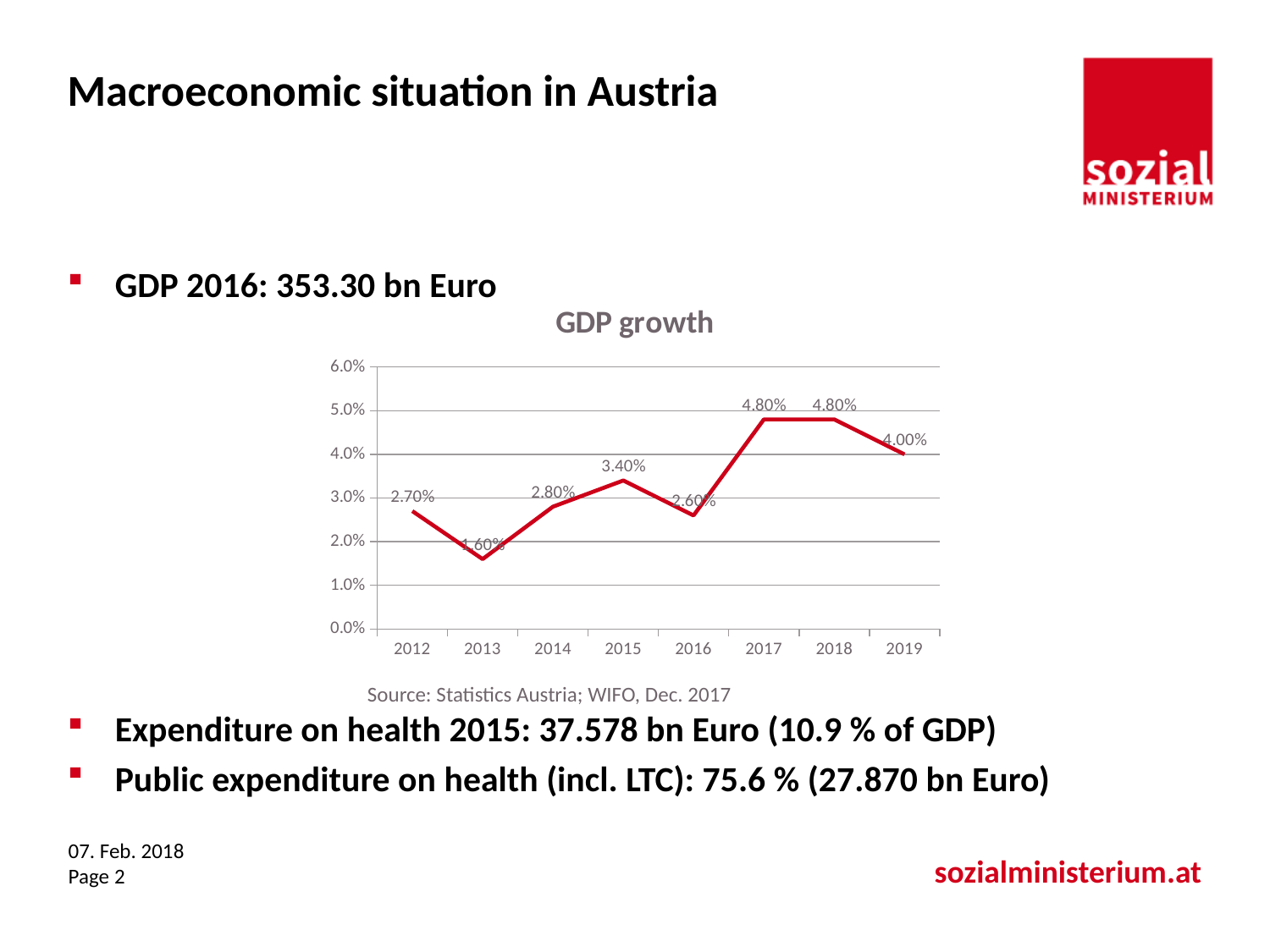
Which year has the lowest GDP growth? 2013 What is the highest value shown on the y axis of the chart? 6.0% What kind of chart is used to show GDP growth? line chart Is the GDP growth value for 2018 greater or less than 4.0%? greater What is the title of the chart? GDP growth Does GDP growth rise or fall from 2016 to 2017? rise How many years are shown on the x axis of the GDP growth chart? 8 What is the GDP growth value for 2012? 2.70% What is the difference in GDP growth between 2017 and 2016? 2.20% Which year has higher GDP growth, 2014 or 2016? 2014 What is the GDP growth value for 2015? 3.40% What is the GDP growth value for 2019? 4.00%